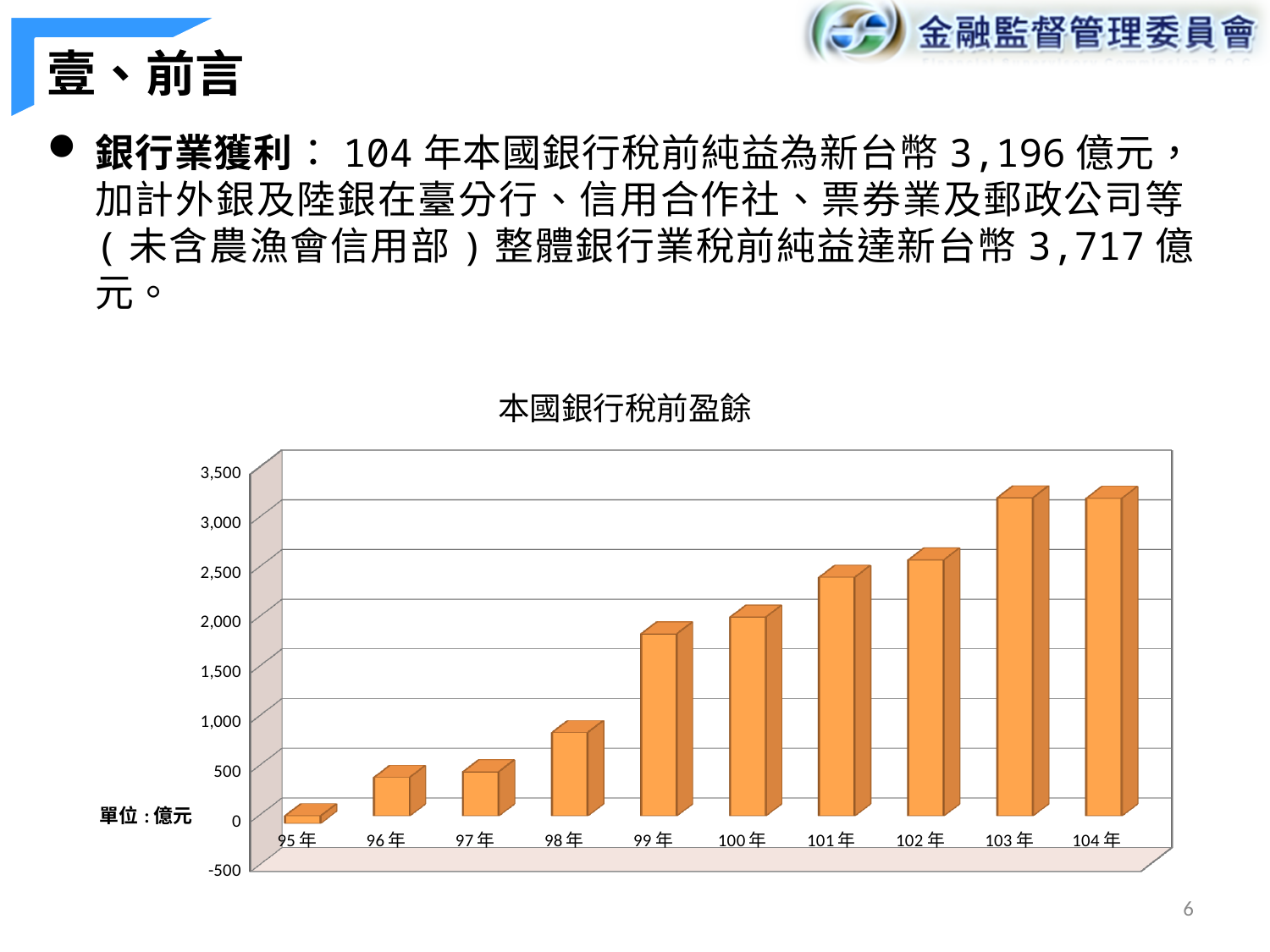
What kind of chart is shown on the slide? Bar chart Do the values generally rise or fall from 95年 to 104年? Rise Which year has the lowest value in the chart? 95年 Which is larger, the value for 98年 or the value for 99年? 99年 Which is larger, the value for 100年 or the value for 101年? 101年 What is the title of the chart? 本國銀行稅前盈餘 Is the value for 99年 greater or less than 1,500? greater Is the value for 103年 greater or less than 3,000? greater What unit is stated for the chart's values? 億元 How many years (categories) are plotted in the chart? 10 Is the value for 96年 greater or less than 500? less